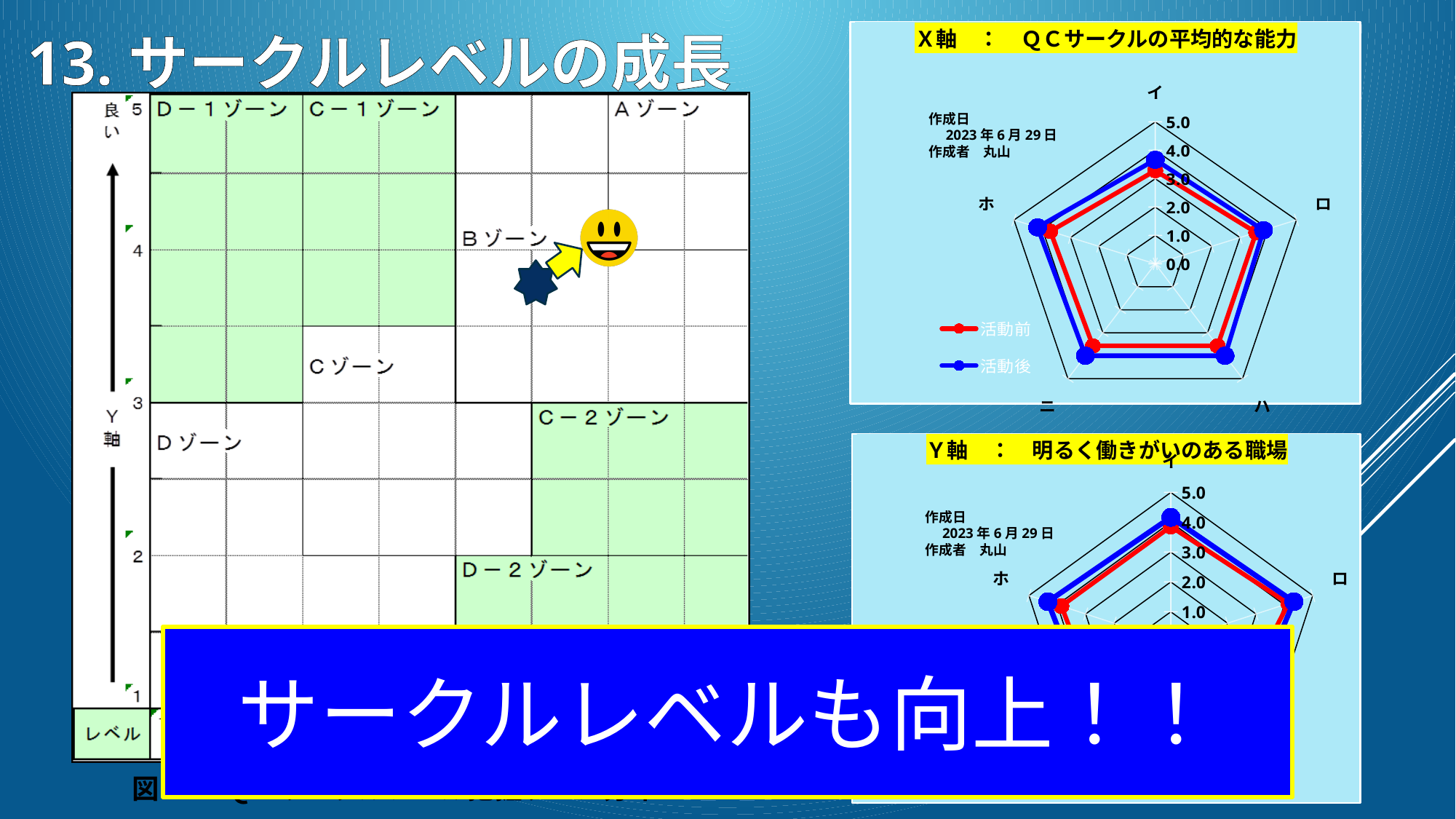
In the 'Y軸 ： 明るく働きがいのある職場' chart, is the 活動後 value for イ greater or less than 3.0? greater In the 'X軸 ： ＱＣサークルの平均的な能力' chart, which series is drawn in red? 活動前 How many series does the legend of the 'X軸 ： ＱＣサークルの平均的な能力' chart list? 2 In the 'X軸 ： ＱＣサークルの平均的な能力' chart, which series has the larger value for ホ, 活動前 or 活動後? 活動後 What kind of chart is the chart titled 'X軸 ： ＱＣサークルの平均的な能力'? radar chart In the 'X軸 ： ＱＣサークルの平均的な能力' chart, is the 活動後 value for イ greater or less than 3.0? greater What is the maximum value shown on the axis scale of the 'Y軸 ： 明るく働きがいのある職場' radar chart? 5.0 In the 'X軸 ： ＱＣサークルの平均的な能力' chart, which series has the larger value for イ, 活動前 or 活動後? 活動後 In the 'X軸 ： ＱＣサークルの平均的な能力' chart, is the 活動前 value for ニ greater or less than 2.0? greater How many categories (axes) does the 'X軸 ： ＱＣサークルの平均的な能力' radar chart have? 5 In the 'X軸 ： ＱＣサークルの平均的な能力' chart, which series is drawn in blue? 活動後